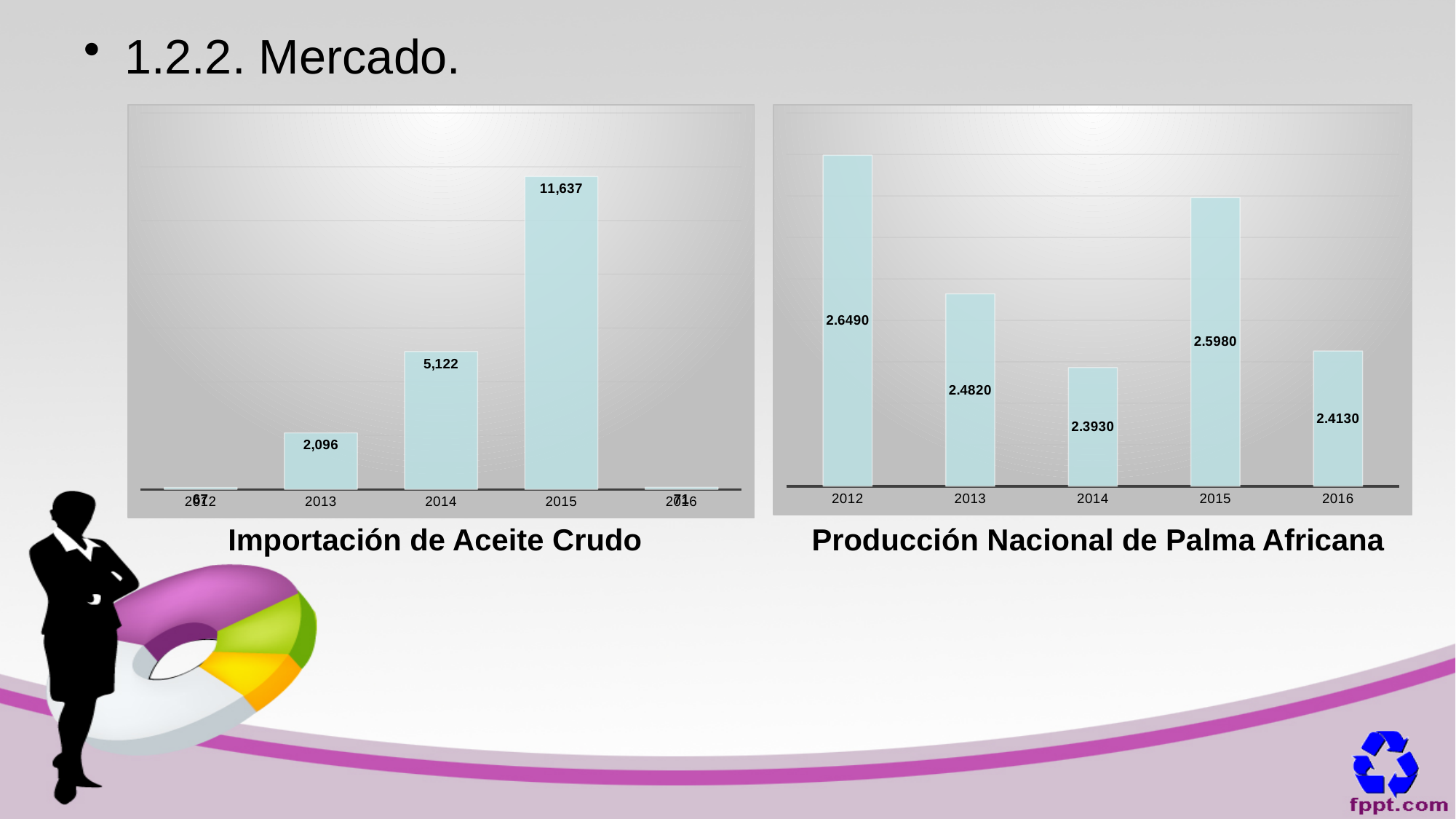
In the 'Importación de Aceite Crudo' chart, which is larger, the value for 2014 or the value for 2013? 2014 What kind of chart is 'Producción Nacional de Palma Africana'? Bar chart In the 'Importación de Aceite Crudo' chart, what is the value for 2013? 2,096 In the 'Importación de Aceite Crudo' chart, what is the difference between the 2015 and 2014 values? 6,515 In the 'Producción Nacional de Palma Africana' chart, which year has the lowest value? 2014 In the 'Producción Nacional de Palma Africana' chart, which is larger, the value for 2015 or the value for 2013? 2015 In the 'Producción Nacional de Palma Africana' chart, what is the value for 2016? 2.4130 In the 'Importación de Aceite Crudo' chart, how many years are shown on the x axis? 5 In the 'Producción Nacional de Palma Africana' chart, which year has the highest value? 2012 In the 'Importación de Aceite Crudo' chart, which year has the highest value? 2015 In the 'Producción Nacional de Palma Africana' chart, what is the value for 2012? 2.6490 In the 'Importación de Aceite Crudo' chart, what is the value for 2015? 11,637